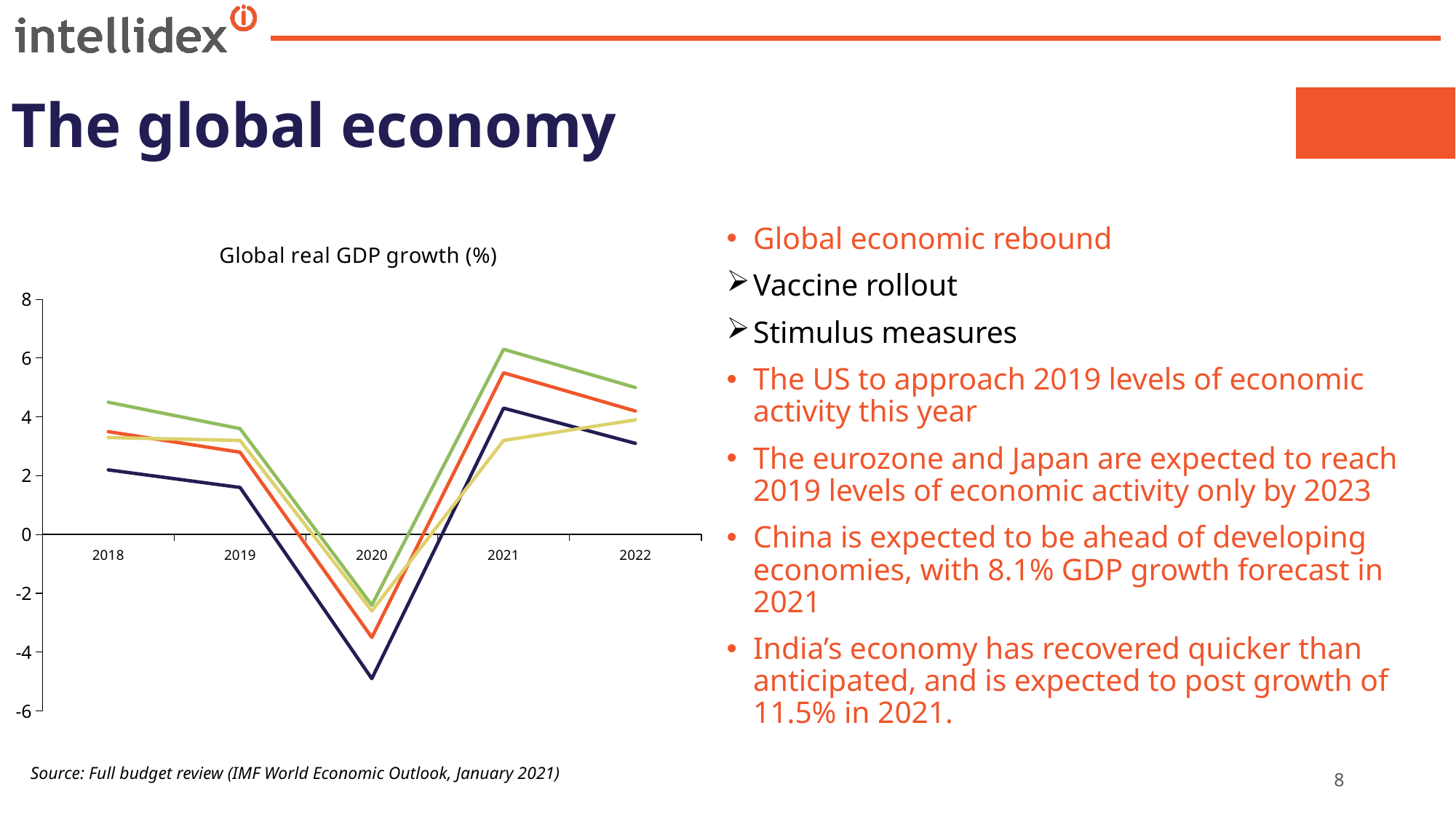
Is the value of the dark navy line in 2019 greater or less than 2? less How many lines are plotted on the chart? 4 Is the value of the orange line in 2021 greater or less than 4? greater What is the title of the chart? Global real GDP growth (%) In which year does the dark navy line reach its lowest value? 2020 In 2020, which line has the lower value: the dark navy line or the orange line? the dark navy line Do the values of all four lines rise or fall from 2019 to 2020? fall Is the value of the dark navy line in 2020 greater or less than -4? less How many years are shown on the x axis of the chart? 5 Does the dark navy line rise or fall from 2021 to 2022? fall What kind of chart is shown on the slide? line chart In which year does the green line reach its highest value? 2021